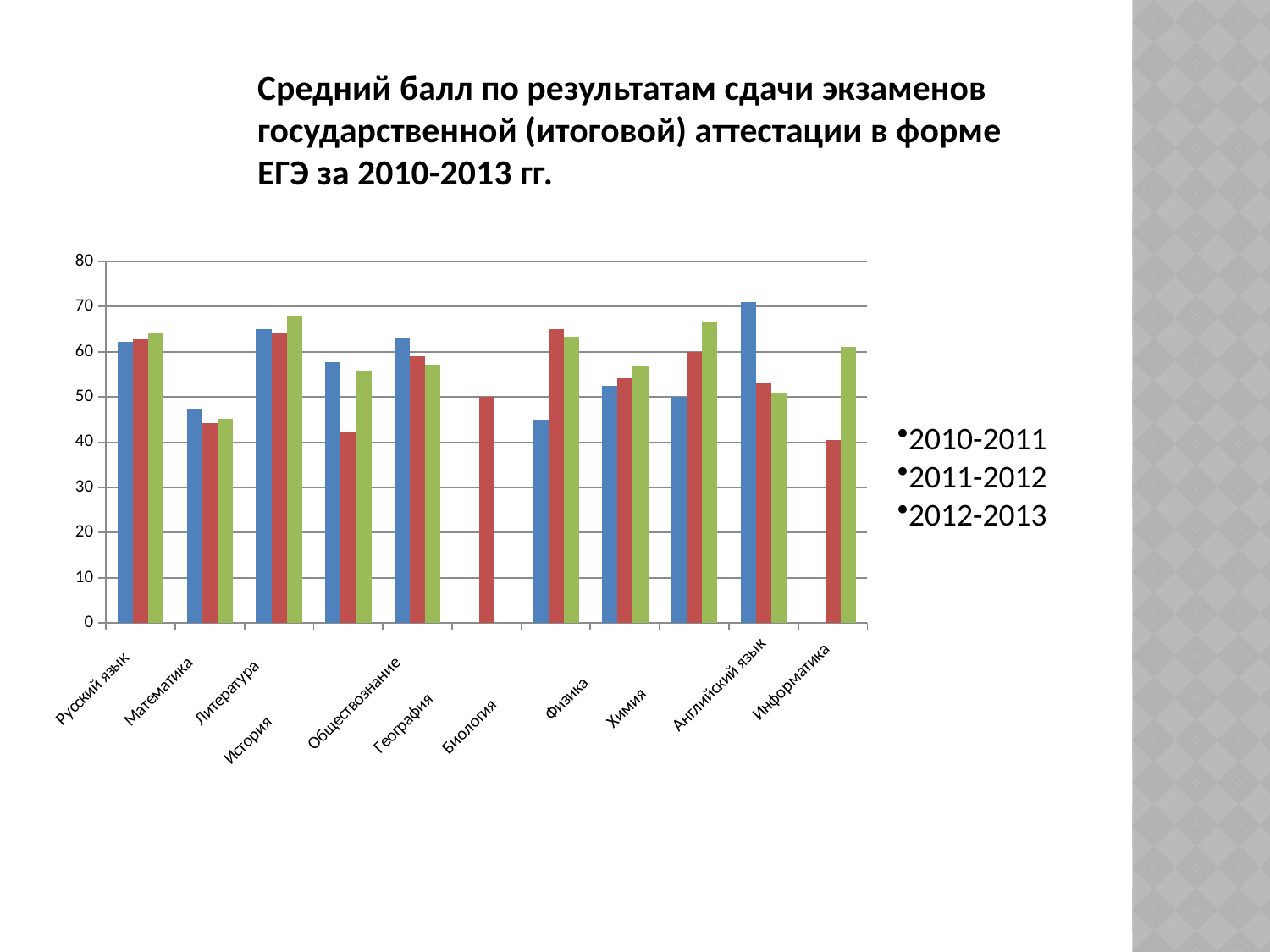
What kind of chart is shown on the slide? bar chart How many series does the legend list? 3 How many subject categories are shown on the x axis of the chart? 11 Are all three bars for Математика greater or less than 50? less Which subject category contains the tallest bar in the chart? Английский язык Is the blue bar for Английский язык greater or less than 60? greater How many bars are plotted for Биология? 3 Is the blue bar for Физика greater or less than 50? greater Which three periods are listed in the chart legend? 2010-2011, 2011-2012, 2012-2013